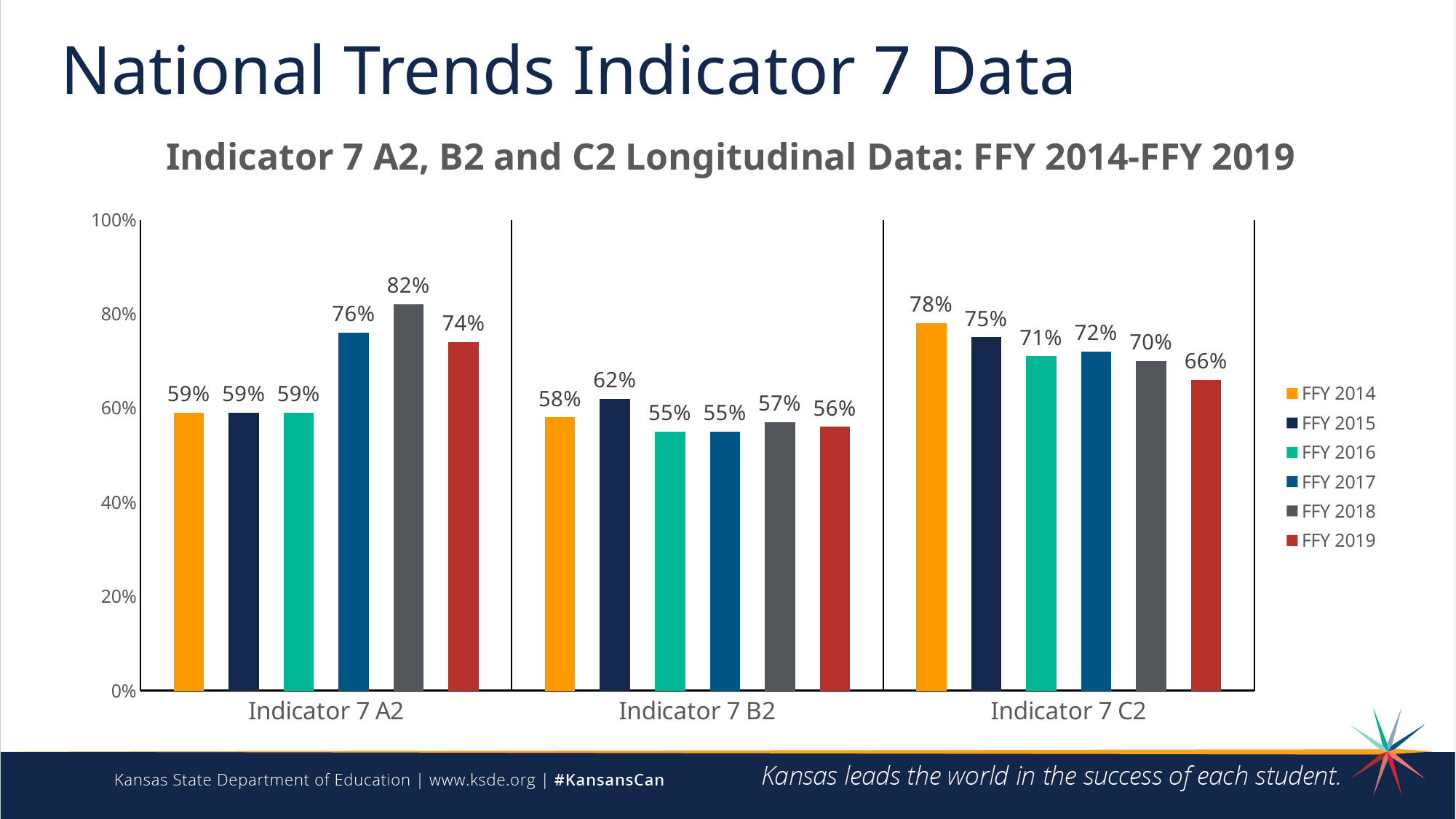
How many series does the legend list? 6 What is the difference between the FFY 2018 and FFY 2014 values in Indicator 7 A2? 23% How many indicator categories are shown on the x axis? 3 Which is larger in Indicator 7 B2: the FFY 2015 value or the FFY 2019 value? FFY 2015 What is the difference between the FFY 2014 and FFY 2019 values in Indicator 7 C2? 12% Which FFY series has the lowest value in Indicator 7 C2? FFY 2019 Which FFY series has the highest value in Indicator 7 A2? FFY 2018 What is the title of the chart? Indicator 7 A2, B2 and C2 Longitudinal Data: FFY 2014-FFY 2019 What is the value for FFY 2018 in Indicator 7 A2? 82% What is the value for FFY 2016 in Indicator 7 B2? 55% What kind of chart is shown on the slide? Bar chart What is the value for FFY 2014 in Indicator 7 C2? 78%